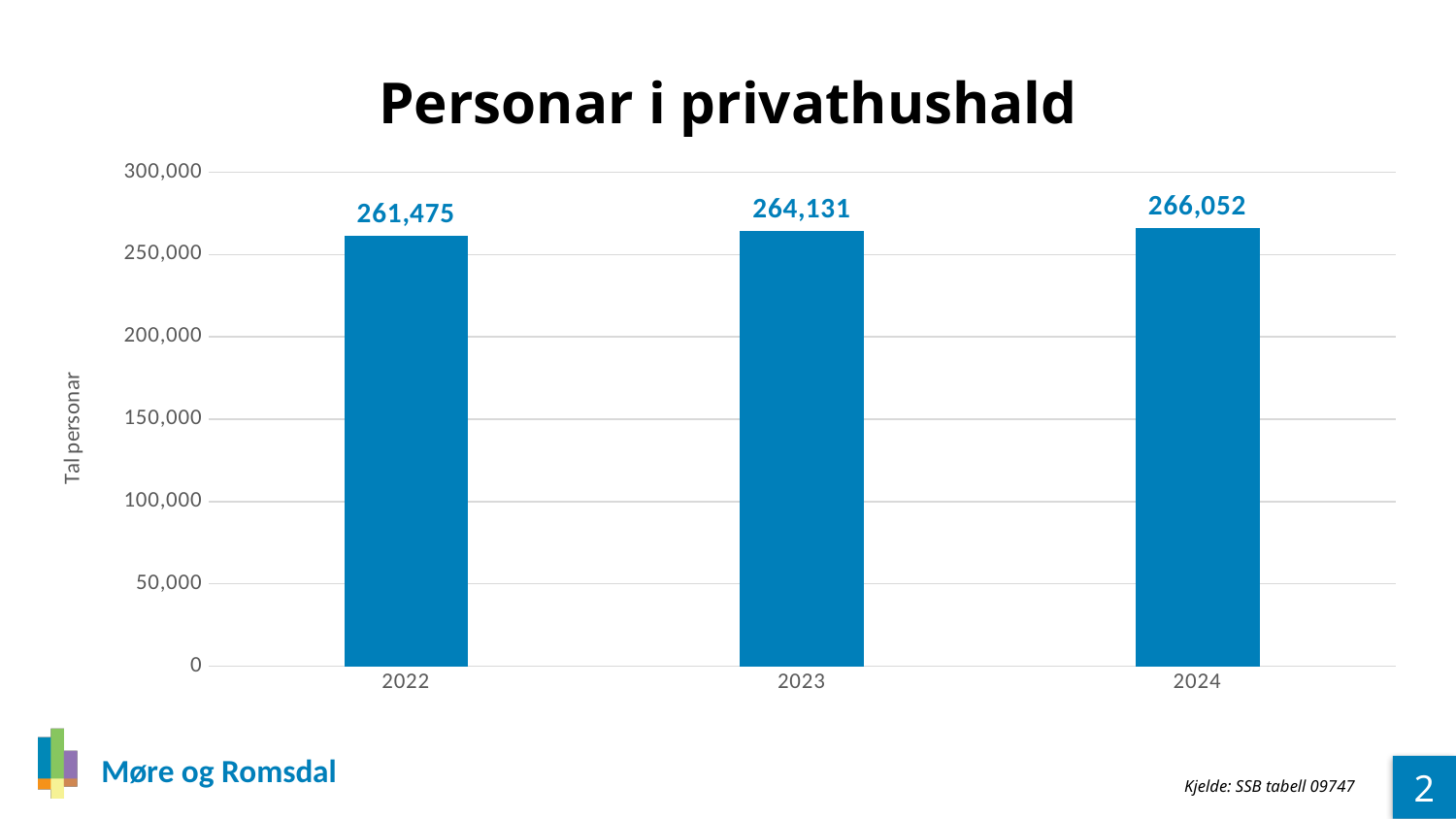
What is the difference between the values for 2023 and 2022? 2,656 How many years are shown on the x axis? 3 Which is larger, the value for 2022 or the value for 2024? 2024 What is the value for 2023? 264,131 What is the difference between the values for 2024 and 2023? 1,921 What is the value for 2022? 261,475 Which year has the lowest value? 2022 What is the value for 2024? 266,052 Is the value for 2023 greater or less than 250,000? greater Which year has the highest value? 2024 Do the values rise or fall from 2022 to 2024? rise What kind of chart is this? bar chart